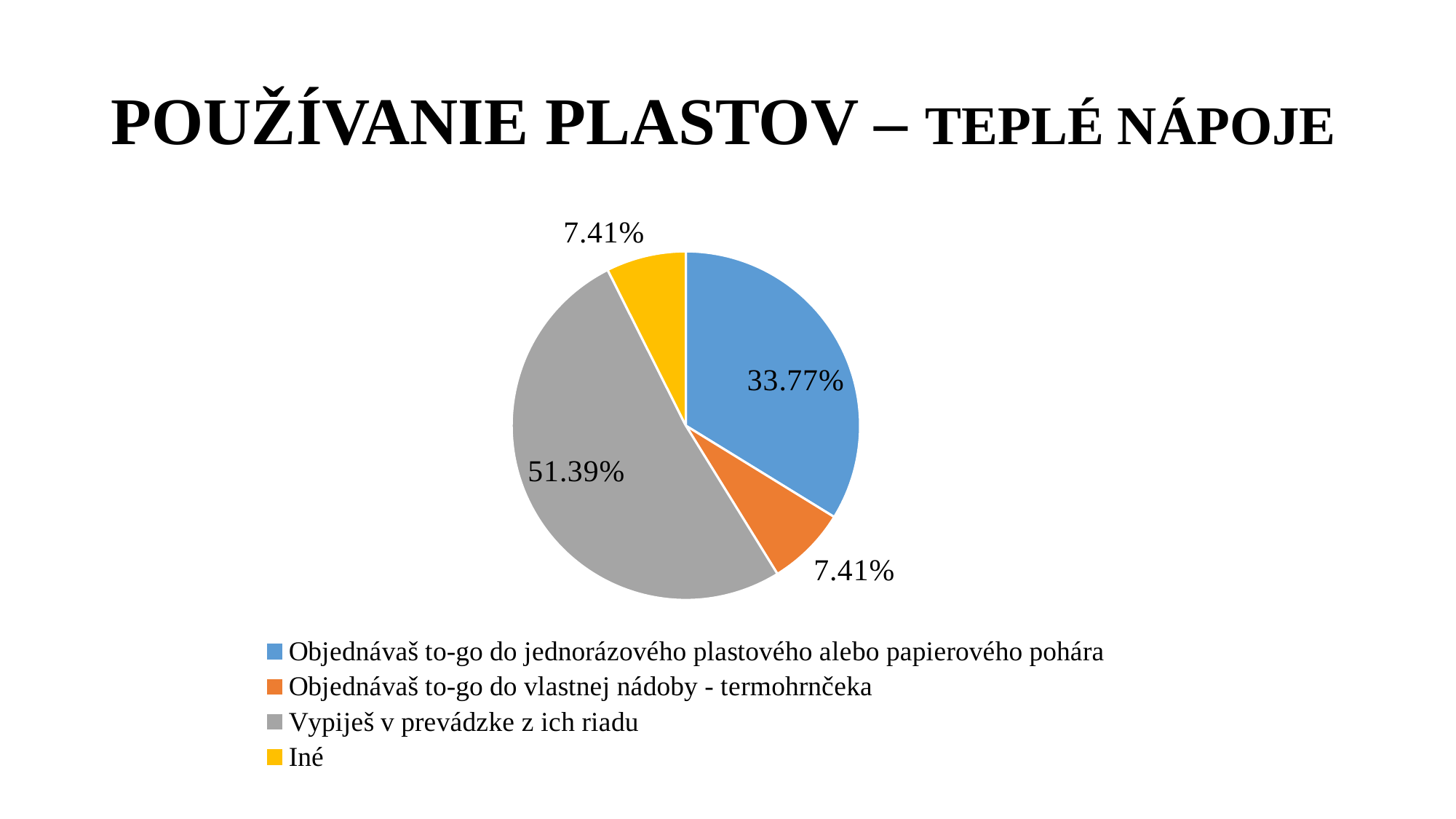
Which is larger: the share for "Objednávaš to-go do jednorázového plastového alebo papierového pohára" or the share for "Iné"? Objednávaš to-go do jednorázového plastového alebo papierového pohára What share of the pie does "Objednávaš to-go do jednorázového plastového alebo papierového pohára" have? 33.77% Which colour represents "Iné" in the pie chart? yellow What share of the pie does "Vypiješ v prevádzke z ich riadu" have? 51.39% What is the difference between the shares for "Objednávaš to-go do jednorázového plastového alebo papierového pohára" and "Objednávaš to-go do vlastnej nádoby - termohrnčeka"? 26.36% How many slices does the pie chart have? 4 What is the difference between the shares for "Vypiješ v prevádzke z ich riadu" and "Objednávaš to-go do jednorázového plastového alebo papierového pohára"? 17.62% What kind of chart is shown on the slide? pie chart What share of the pie does "Objednávaš to-go do vlastnej nádoby - termohrnčeka" have? 7.41% What share of the pie does "Iné" have? 7.41% Which category has the largest slice of the pie? Vypiješ v prevádzke z ich riadu What is the title of the slide? POUŽÍVANIE PLASTOV – TEPLÉ NÁPOJE